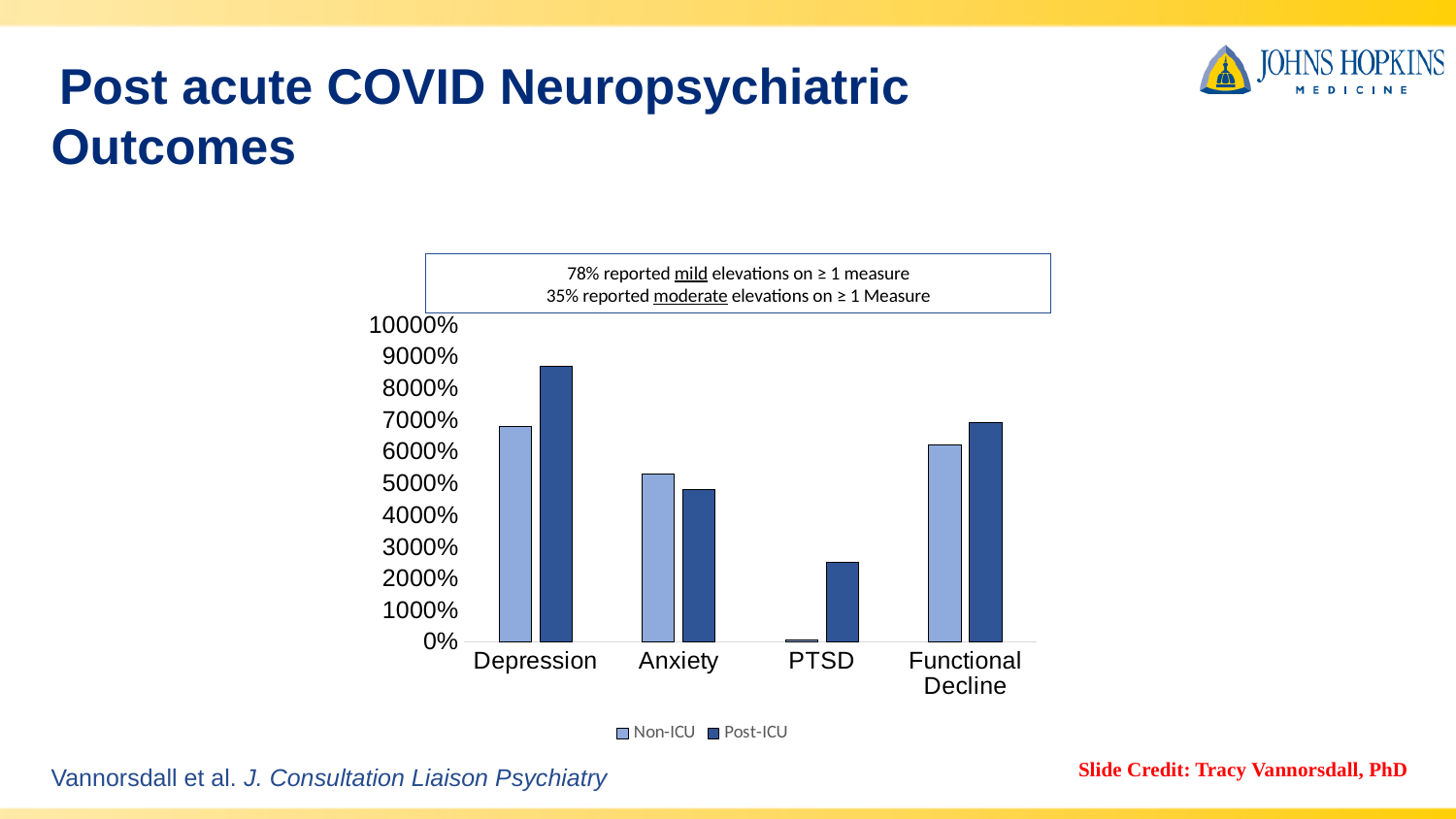
Which category has the highest Post-ICU bar? Depression Is the Post-ICU value for PTSD greater or less than 3000%? less How many series does the chart's legend list? 2 Is the Non-ICU value for PTSD greater or less than 1000%? less What are the two series named in the chart's legend? Non-ICU and Post-ICU Which category has the lowest Non-ICU bar? PTSD For Depression, which series has the larger value, Non-ICU or Post-ICU? Post-ICU Is the Post-ICU value for Depression greater or less than 8000%? greater How many categories are shown on the x axis of the chart? 4 For Anxiety, which series has the larger value, Non-ICU or Post-ICU? Non-ICU What kind of chart is shown on the slide? bar chart